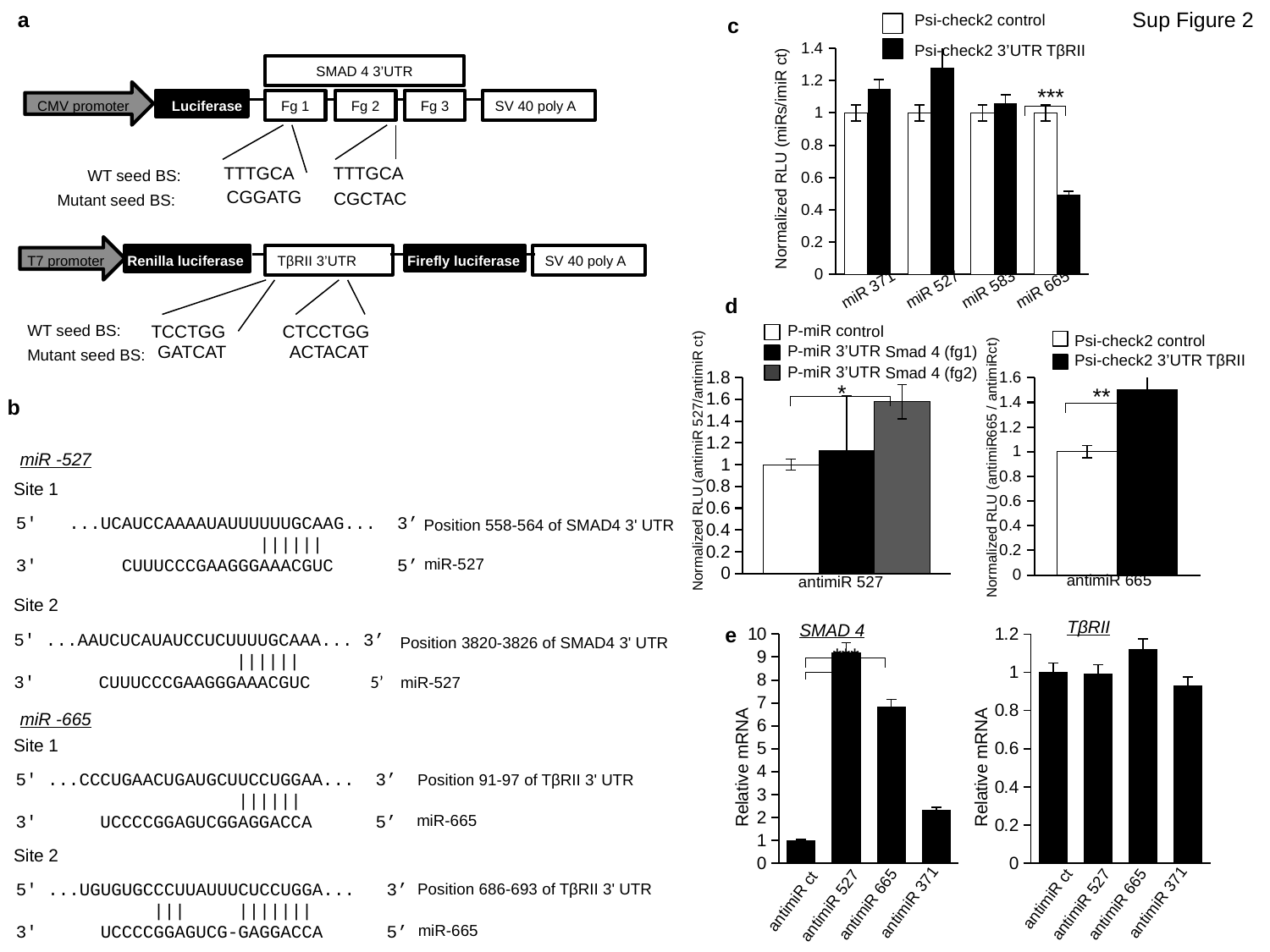
In the SMAD 4 chart in panel e, is the value for antimiR 371 greater or less than 3? less In the panel c chart, which miR has the highest Psi-check2 3'UTR TβRII value? miR 527 In the right panel d chart (antimiR 665), is the Psi-check2 3'UTR TβRII value greater or less than 1.2? greater In the panel c chart, is the Psi-check2 3'UTR TβRII value for miR 665 greater or less than 0.8? less In the left panel d chart (antimiR 527), how many series does the legend list? 3 What kind of chart is the TβRII chart in panel e? bar chart In the SMAD 4 chart in panel e, which category has the highest relative mRNA? antimiR 527 In the TβRII chart in panel e, which category has the highest relative mRNA? antimiR 665 In the panel c chart, how many series does the legend list? 2 In the panel c chart, which miR has the lowest Psi-check2 3'UTR TβRII value? miR 665 In the panel c chart, how many miR categories are shown on the x axis? 4